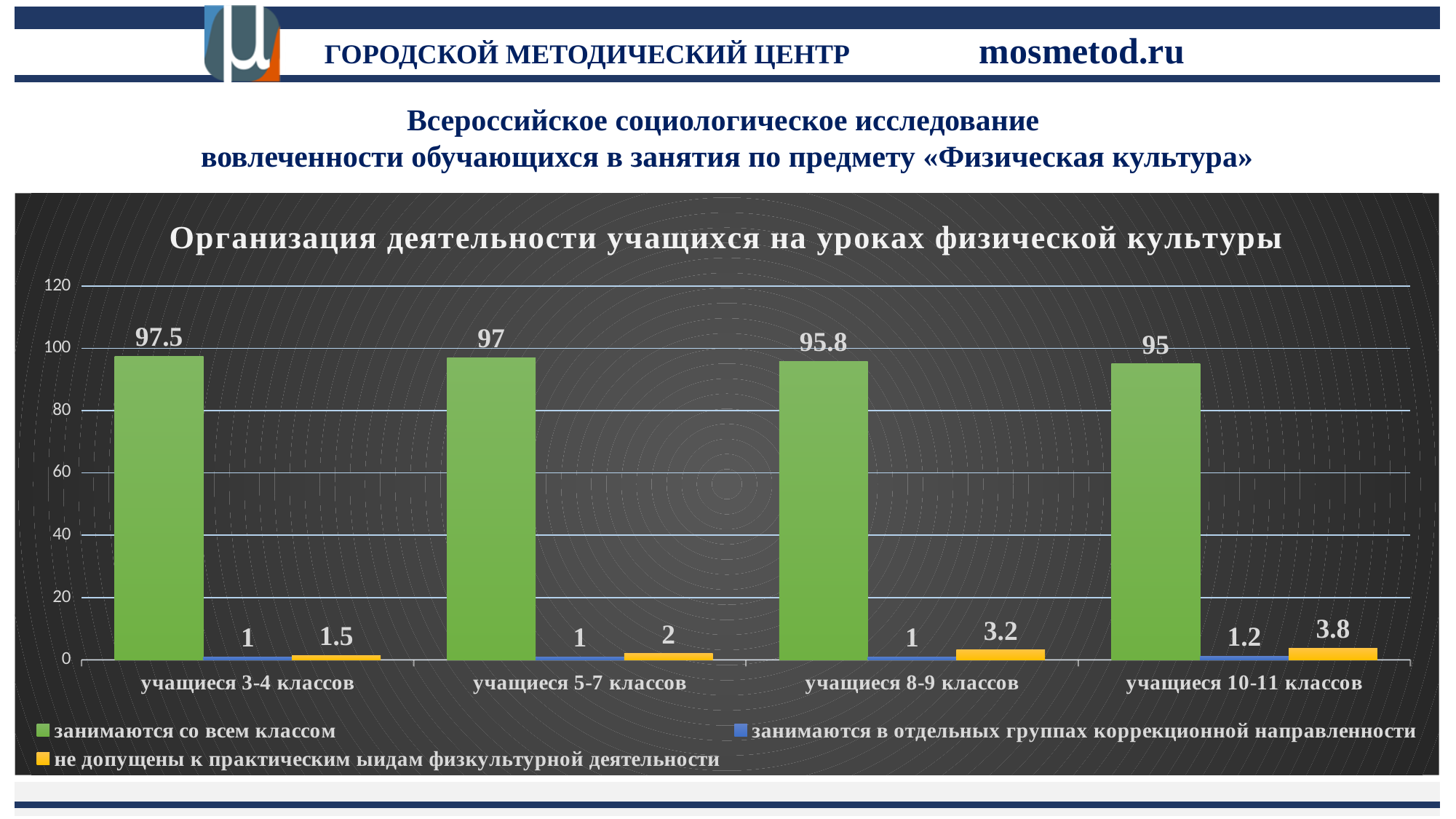
What is the value for "занимаются в отдельных группах коррекционной направленности" for учащиеся 10-11 классов? 1.2 How many series does the legend list? 3 Which is larger: the "не допущены к практическим ыидам физкультурной деятельности" value for учащиеся 5-7 классов or for учащиеся 10-11 классов? учащиеся 10-11 классов Do the values for "занимаются со всем классом" rise or fall from учащиеся 3-4 классов to учащиеся 10-11 классов? fall Which category has the highest value for "занимаются со всем классом"? учащиеся 3-4 классов How many categories are shown on the x axis? 4 What is the value for "занимаются со всем классом" for учащиеся 3-4 классов? 97.5 What type of chart is shown on the slide? bar chart What is the value for "не допущены к практическим ыидам физкультурной деятельности" for учащиеся 8-9 классов? 3.2 Which category has the lowest value for "не допущены к практическим ыидам физкультурной деятельности"? учащиеся 3-4 классов What is the difference between the "занимаются со всем классом" values for учащиеся 3-4 классов and учащиеся 10-11 классов? 2.5 Is the value for "занимаются со всем классом" for учащиеся 8-9 классов greater or less than 80? greater